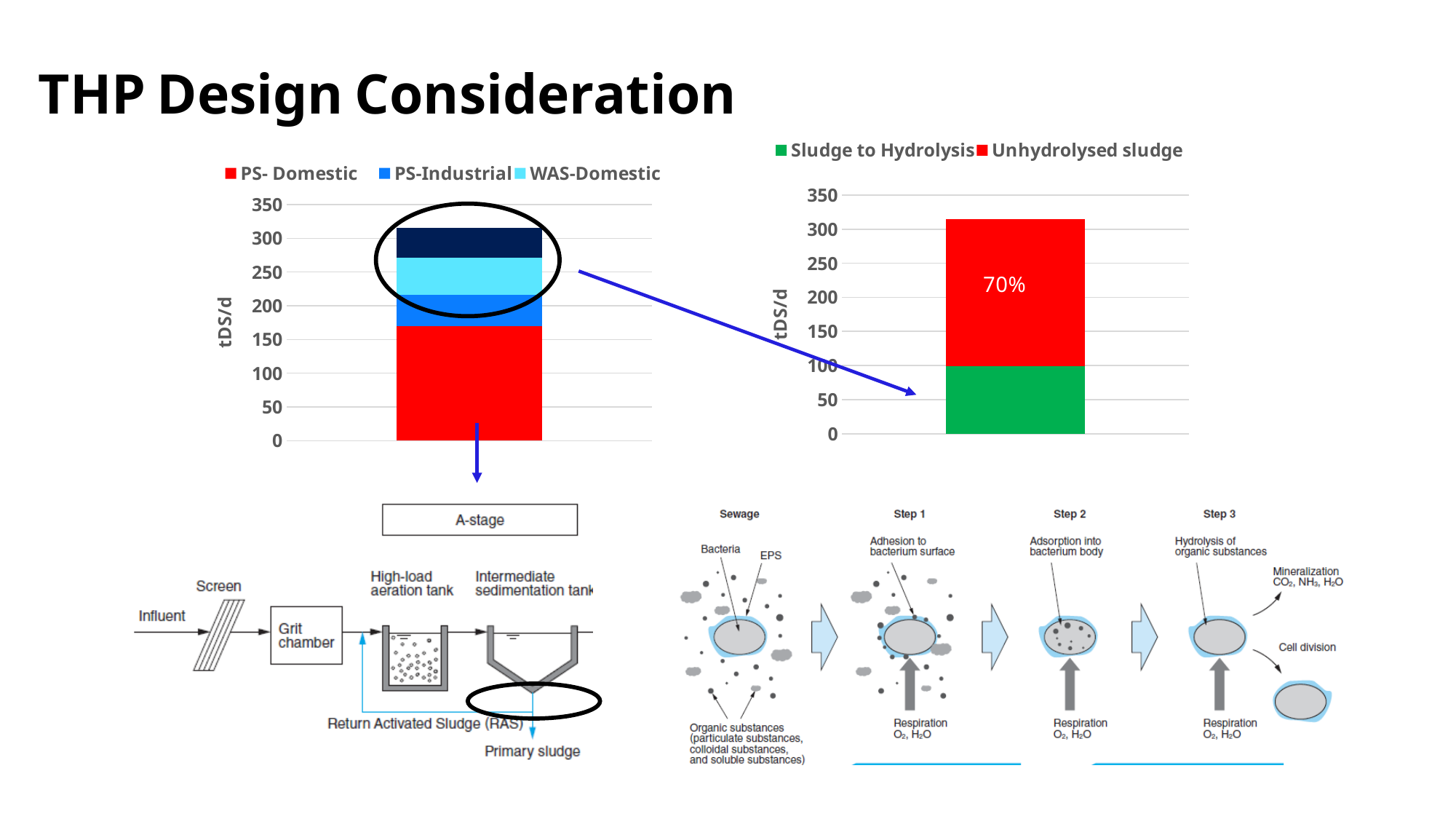
In the left chart, which legend series has the largest segment? PS- Domestic In the right chart, which segment is larger: Sludge to Hydrolysis or Unhydrolysed sludge? Unhydrolysed sludge In the right chart, what percentage label is printed on the Unhydrolysed sludge segment? 70% In the right chart, is the total height of the stacked bar greater or less than 300? greater What is the y-axis label on the right chart? tDS/d In the left chart, is the value for PS- Domestic greater or less than 150? greater In the left chart, is the value for PS- Domestic greater or less than 200? less How many series does the legend of the left chart list? 3 In the left chart, which segment is larger: PS- Domestic or PS-Industrial? PS- Domestic What kind of chart is the left chart with the PS- Domestic legend? stacked bar chart How many series does the legend of the right chart list? 2